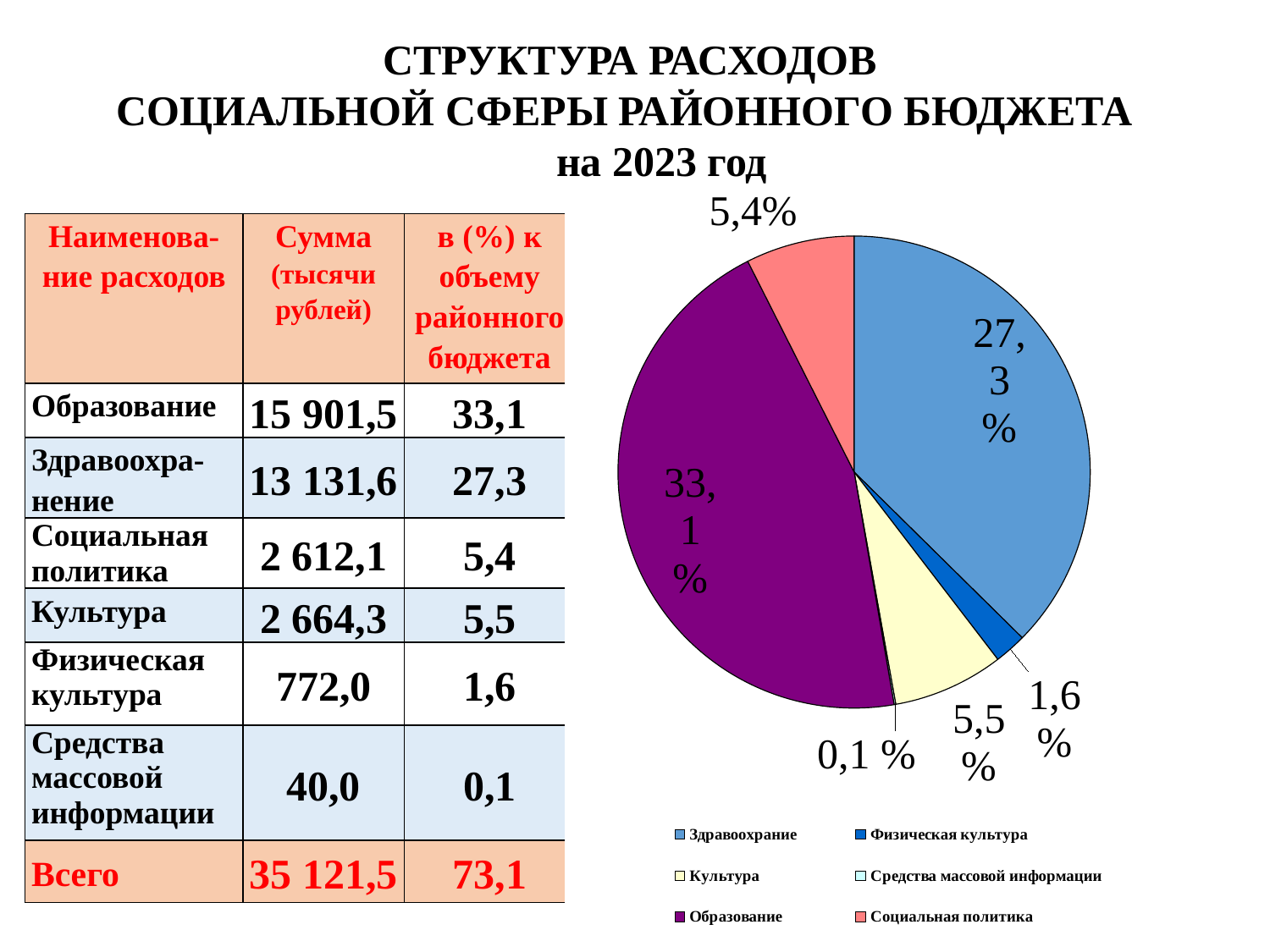
What share of the pie chart does Здравоохранение have? 27,3% What kind of chart is shown on the slide? pie chart What share of the pie chart does Средства массовой информации have? 0,1% What share of the pie chart does Физическая культура have? 1,6% Which category has the largest slice in the pie chart? Образование How many categories does the pie chart legend list? 6 What is the difference in percentage points between the Образование and Здравоохранение slices? 5,8 What share of the pie chart does Образование have? 33,1% Which slice is larger in the pie chart: Здравоохранение or Социальная политика? Здравоохранение What share of the pie chart does Социальная политика have? 5,4% What colour is the Образование slice in the pie chart? purple Which category has the smallest slice in the pie chart? Средства массовой информации